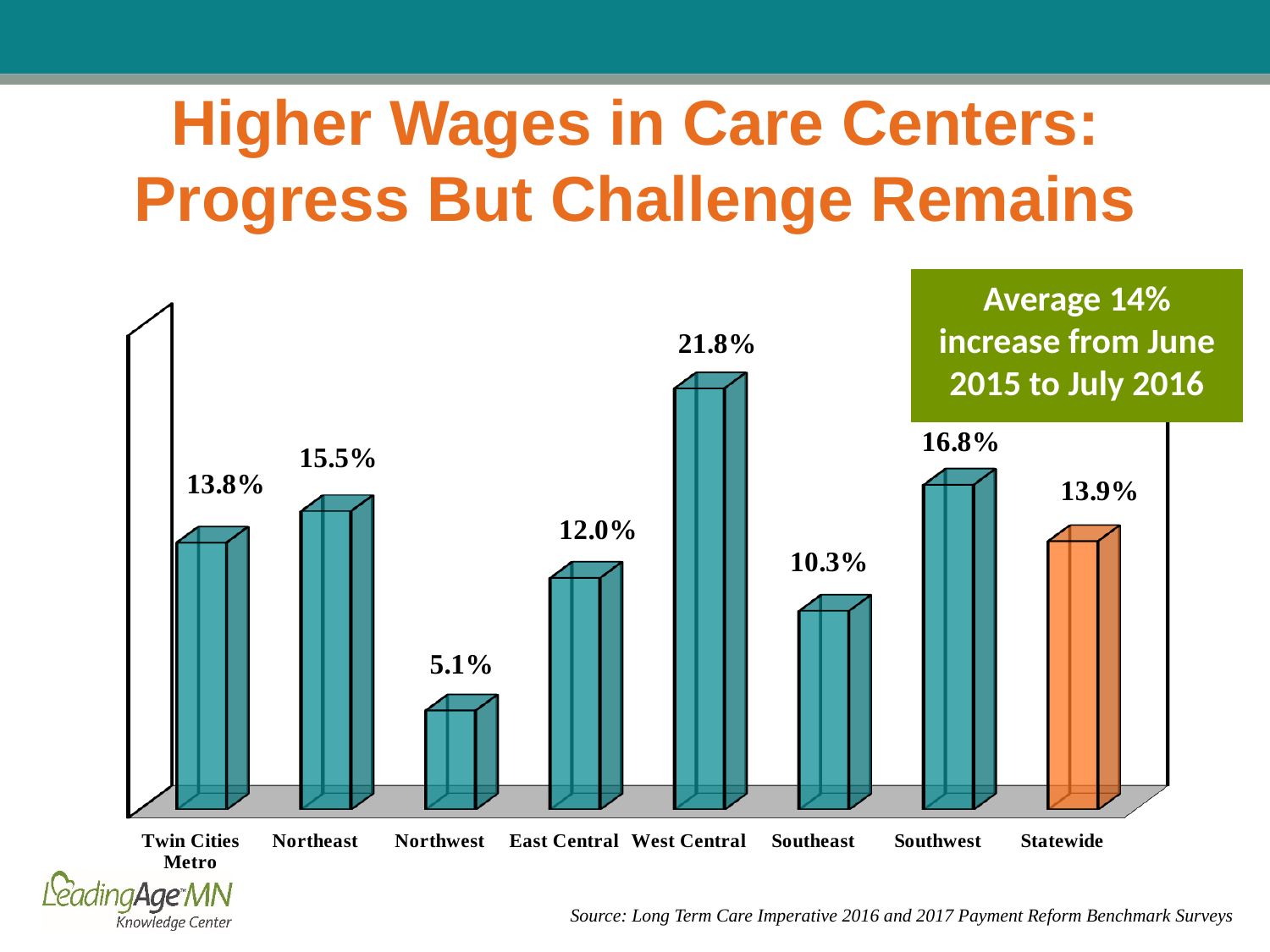
How many categories are shown on the x axis? 8 What is the value for Northwest? 5.1% What is the value for Statewide? 13.9% Which bar is shown in a different colour (orange) from the others? Statewide What kind of chart is shown on the slide? Bar chart Which category has the highest value? West Central What is the difference between the values for Southwest and Statewide? 2.9% What is the value for West Central? 21.8% What is the value for Southeast? 10.3% Which category has the lowest value? Northwest Which is larger, the value for Northeast or the value for East Central? Northeast What is the difference between the values for West Central and Northwest? 16.7%